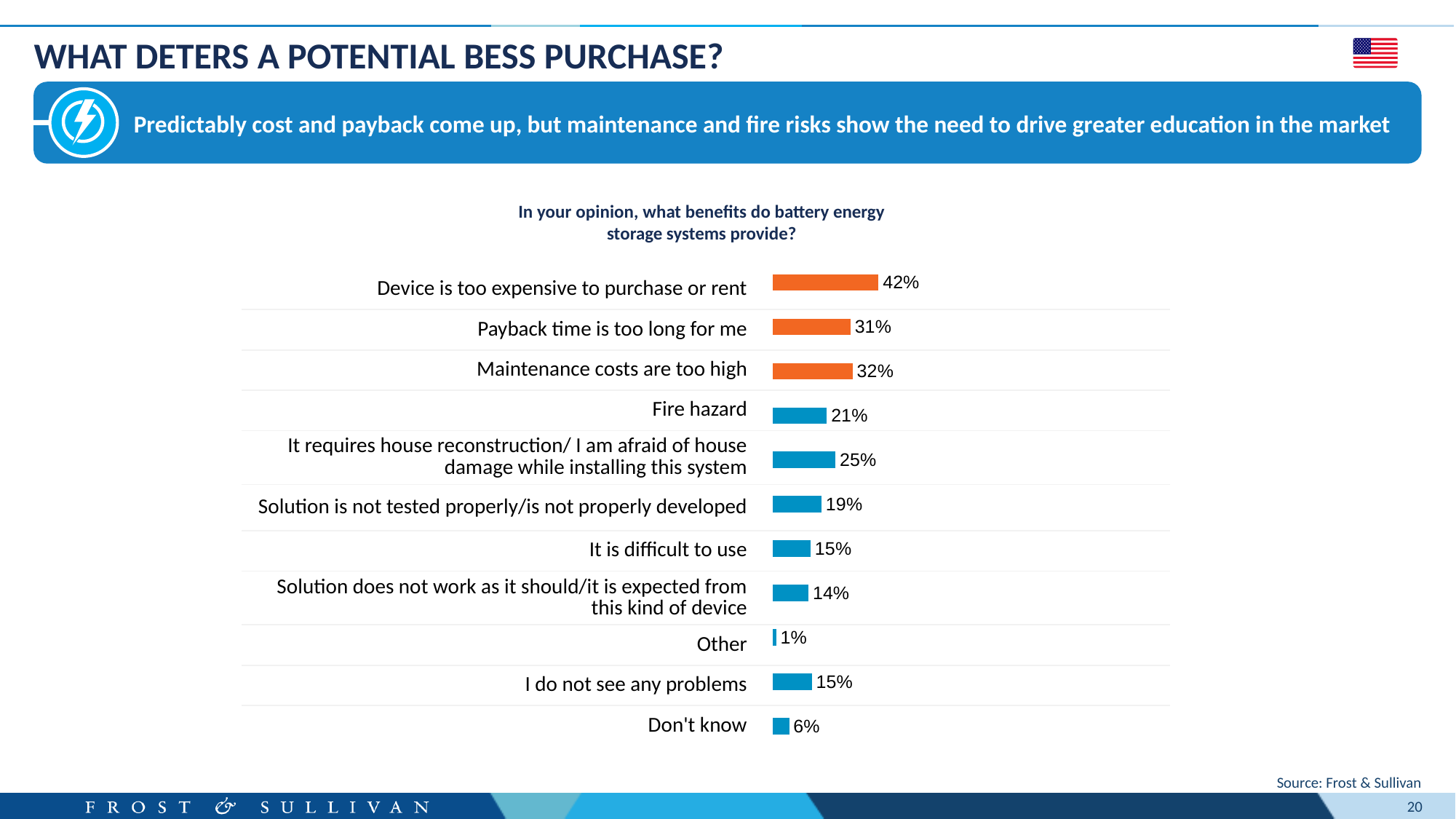
What is the difference between 'Solution is not tested properly/is not properly developed' and 'Solution does not work as it should/it is expected from this kind of device'? 5% Which is larger: 'Maintenance costs are too high' or 'Payback time is too long for me'? Maintenance costs are too high What is the value for 'Don't know'? 6% How many bars are coloured orange rather than blue? 3 What is the value for 'Fire hazard'? 21% What is the value for 'It requires house reconstruction/ I am afraid of house damage while installing this system'? 25% How many categories are shown in the chart? 11 What percentage of respondents said the device is too expensive to purchase or rent? 42% What kind of chart is shown on the slide? Bar chart Which category has the highest value? Device is too expensive to purchase or rent Which category has the lowest value? Other What is the difference between 'Device is too expensive to purchase or rent' and 'Payback time is too long for me'? 11%